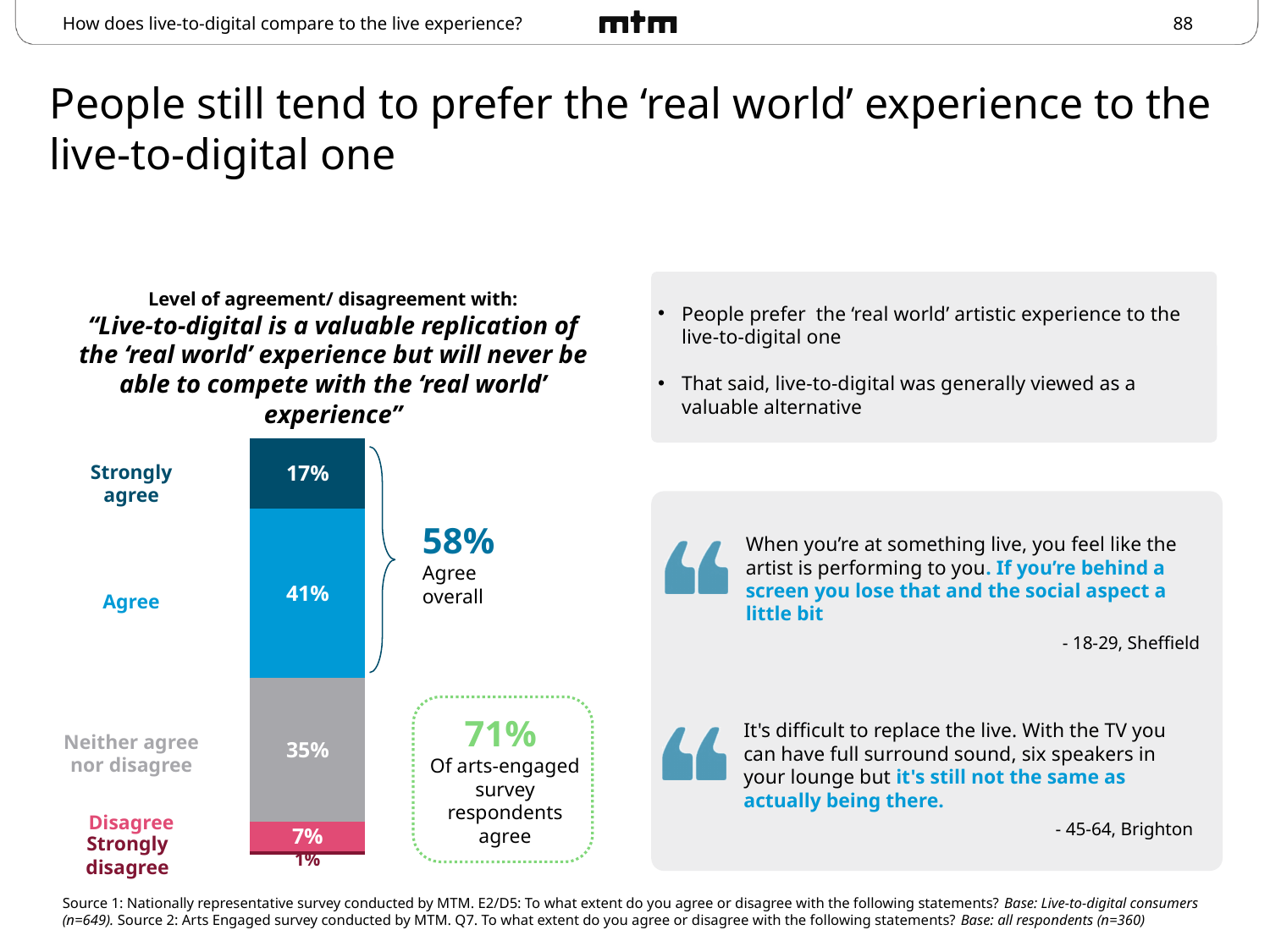
What type of chart is used to show the level of agreement? Stacked bar chart What percentage of respondents strongly agree with the statement? 17% Which response category has the largest share? Agree What is the difference between the 'Agree' and 'Neither agree nor disagree' percentages? 6% What percentage of respondents agree with the statement? 41% Which is larger, the 'Strongly agree' share or the 'Disagree' share? Strongly agree What percentage of respondents strongly disagree with the statement? 1% What percentage of respondents disagree with the statement? 7% How many response categories are shown in the stacked bar? 5 Which response category has the smallest share? Strongly disagree What percentage is labelled as 'Agree overall' next to the bar? 58% What percentage of respondents neither agree nor disagree? 35%